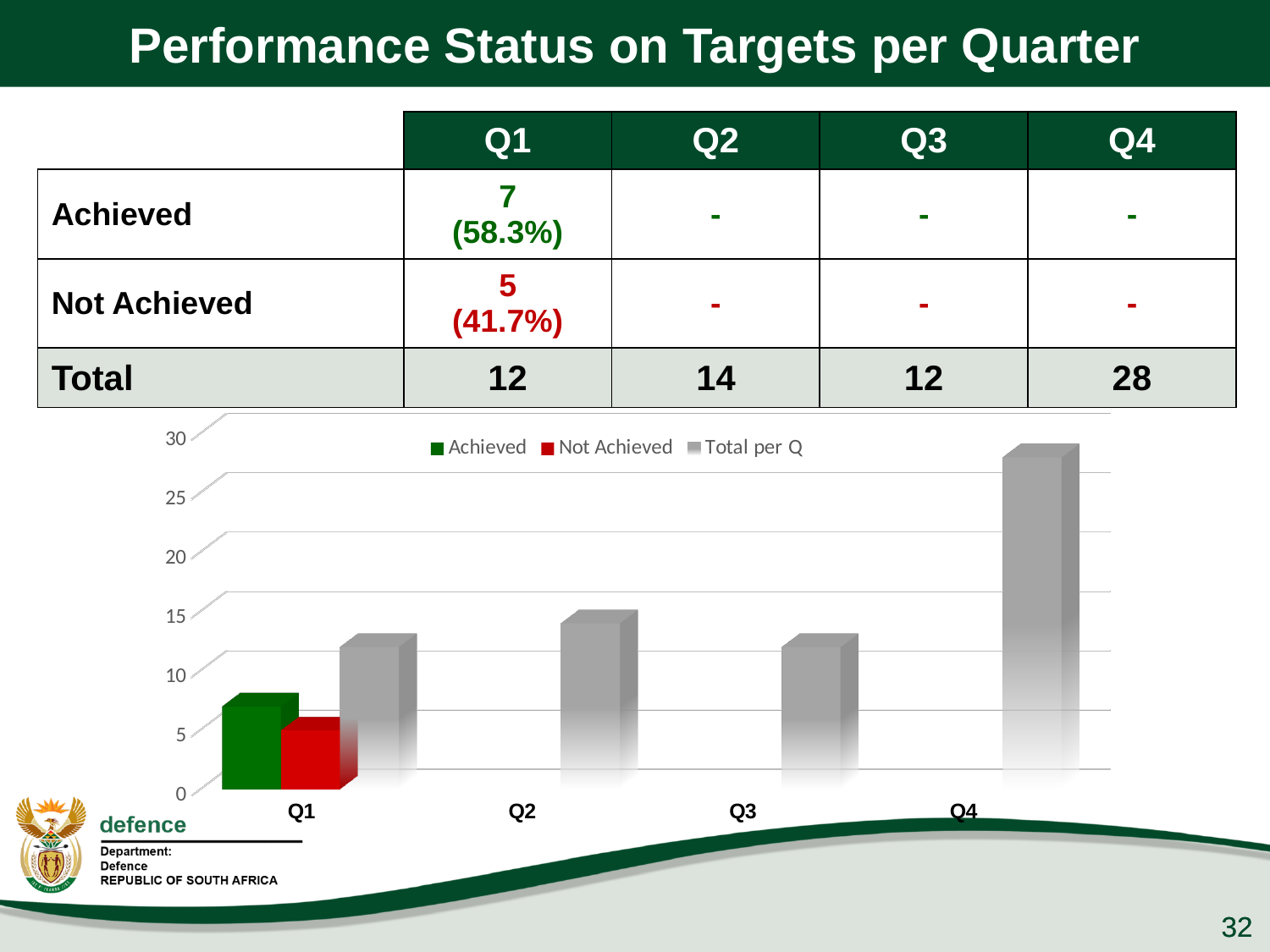
What is the difference between the Total per Q values for Q4 and Q2? 14 In Q1, which is larger, the Achieved bar or the Not Achieved bar? Achieved Which quarter has the highest Total per Q bar? Q4 What is the Total per Q value for Q4? 28 What is the Achieved value for Q1? 7 What is the Total per Q value for Q2? 14 How many quarters are shown on the x axis of the chart? 4 How many series does the chart legend list? 3 What kind of chart is shown on the slide? bar chart What colour represents the Achieved series in the chart? green Is the Total per Q value for Q2 greater or less than 15? less Is the Total per Q value for Q4 greater or less than 25? greater